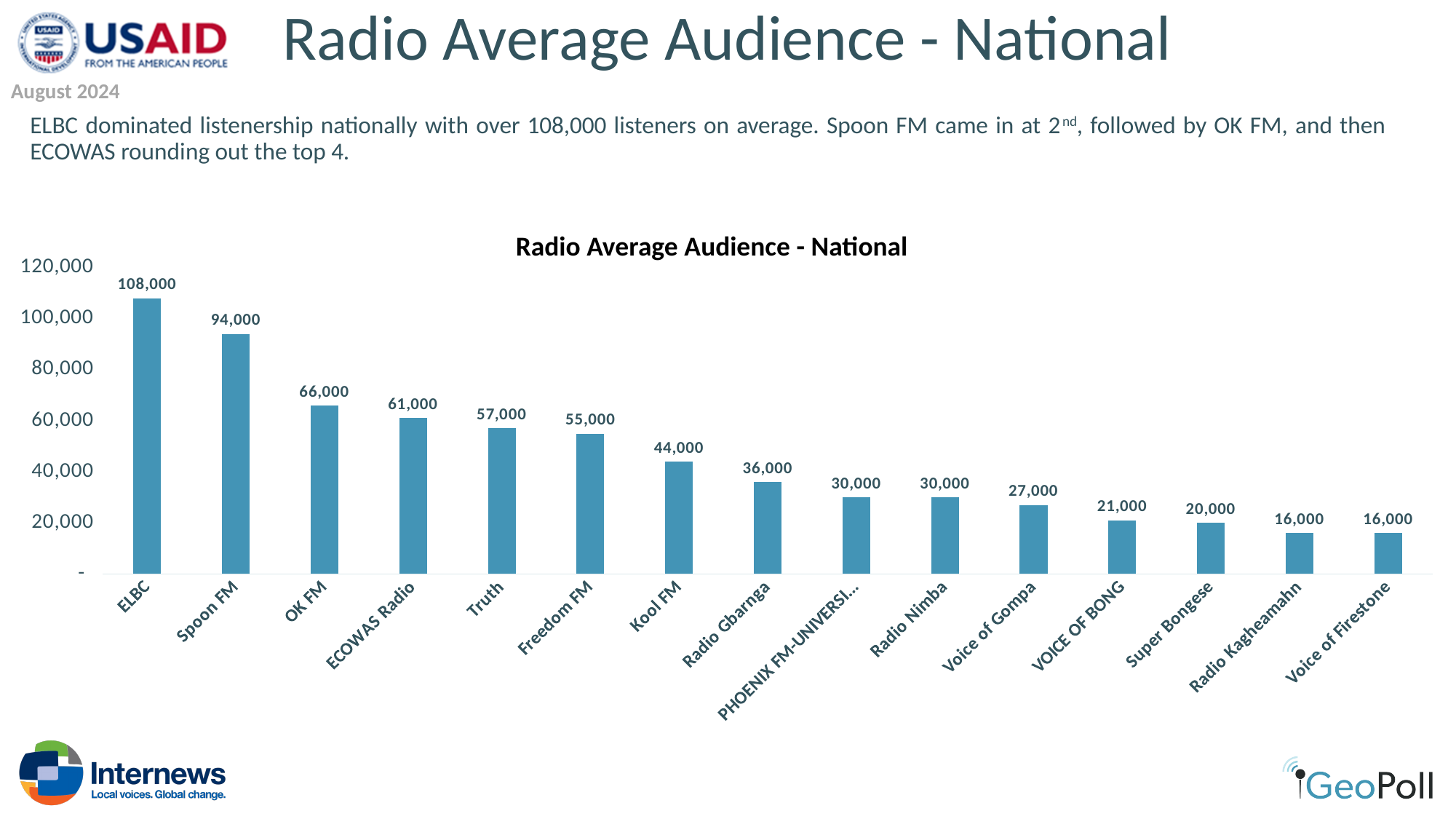
Do the values rise or fall from left to right along the x axis? Fall Which station has the highest average audience? ELBC What is the difference between the values for OK FM and ECOWAS Radio? 5,000 Is the value for Freedom FM greater or less than 60,000? less What kind of chart is shown on the slide? Bar chart Which has a larger average audience, Truth or Radio Gbarnga? Truth What is the average audience value for Voice of Gompa? 27,000 How many stations are shown in the chart? 15 What is the average audience value for Spoon FM? 94,000 What is the average audience value for Kool FM? 44,000 What is the difference between the values for ELBC and Spoon FM? 14,000 Which has a larger average audience, Super Bongese or VOICE OF BONG? VOICE OF BONG